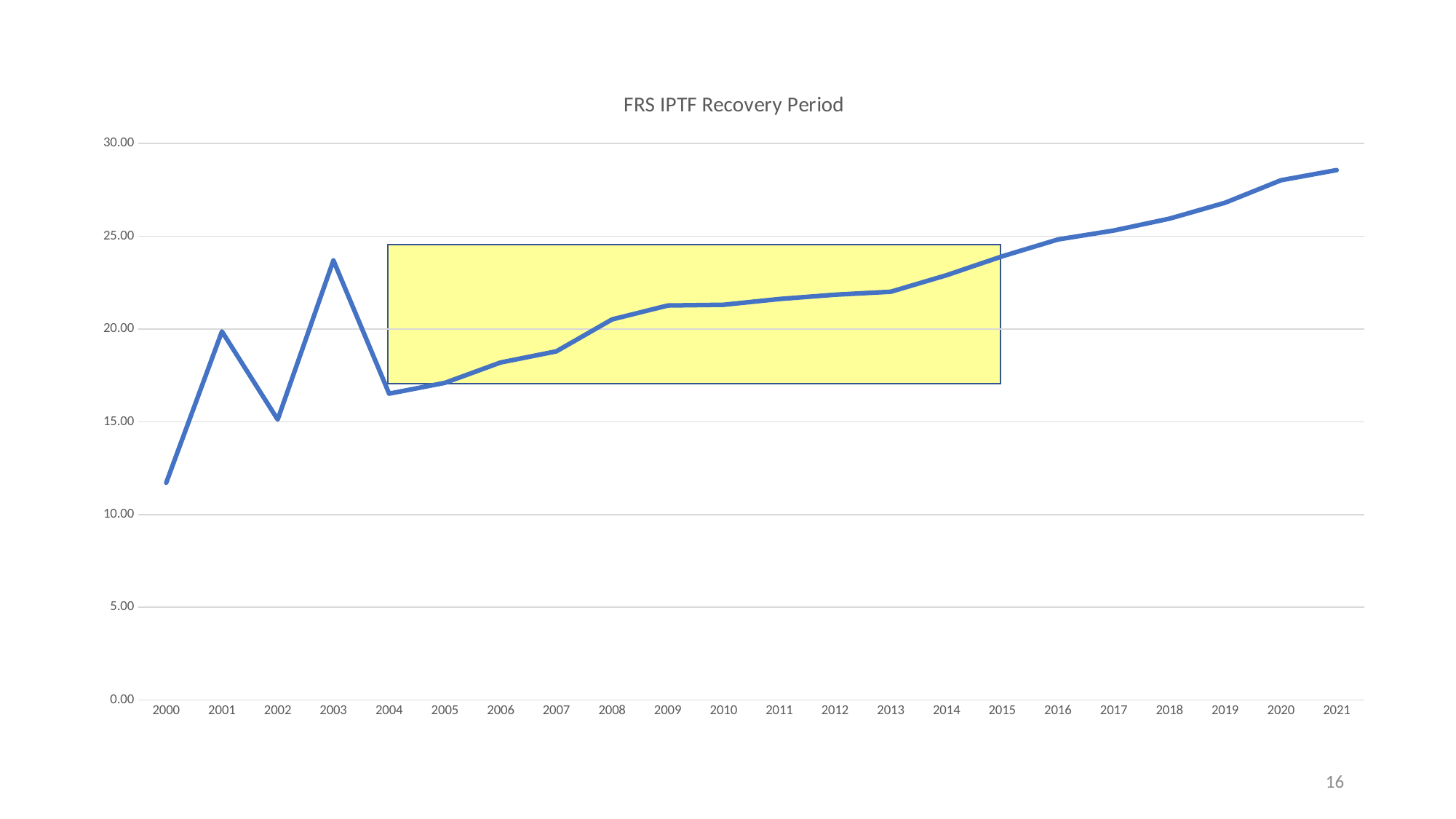
What is the title of the chart? FRS IPTF Recovery Period What kind of chart is shown on the slide? Line chart Which range of years does the yellow highlighted box on the chart cover? 2004 to 2015 Which year has the highest value in the chart? 2021 Is the value for 2013 greater or less than 20.00? greater Do the values rise or fall along the x axis from 2004 to 2021? Rise Which year has the larger value, 2002 or 2003? 2003 Is the value for 2003 greater or less than 25.00? less Is the value for 2000 greater or less than 15.00? less How many years are plotted along the x axis of the chart? 22 Which year has the lowest value in the chart? 2000